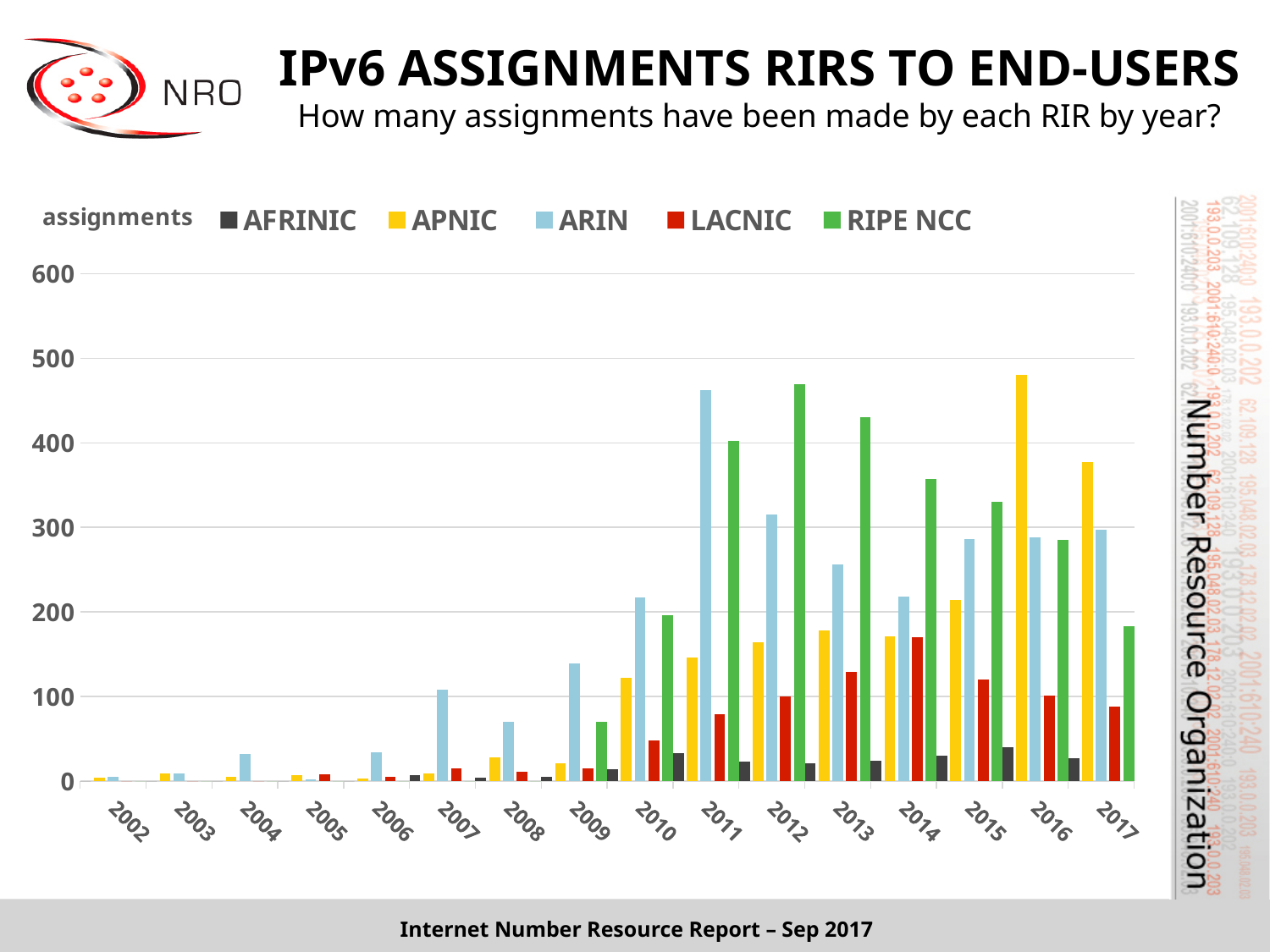
Is the value for RIPE NCC in 2012 greater or less than 400? greater In 2016, which had more assignments, APNIC or ARIN? APNIC Which RIR had the highest number of assignments in 2014? RIPE NCC Is the value for ARIN in 2011 greater or less than 400? greater Which RIR had the lowest number of assignments in 2016? AFRINIC How many RIR series does the legend list? 5 In 2011, which had more assignments, ARIN or RIPE NCC? ARIN What kind of chart is shown on the slide? bar chart Do the RIPE NCC values rise or fall from 2012 to 2017? fall Is the value for LACNIC in 2017 greater or less than 100? less How many years are shown along the x axis? 16